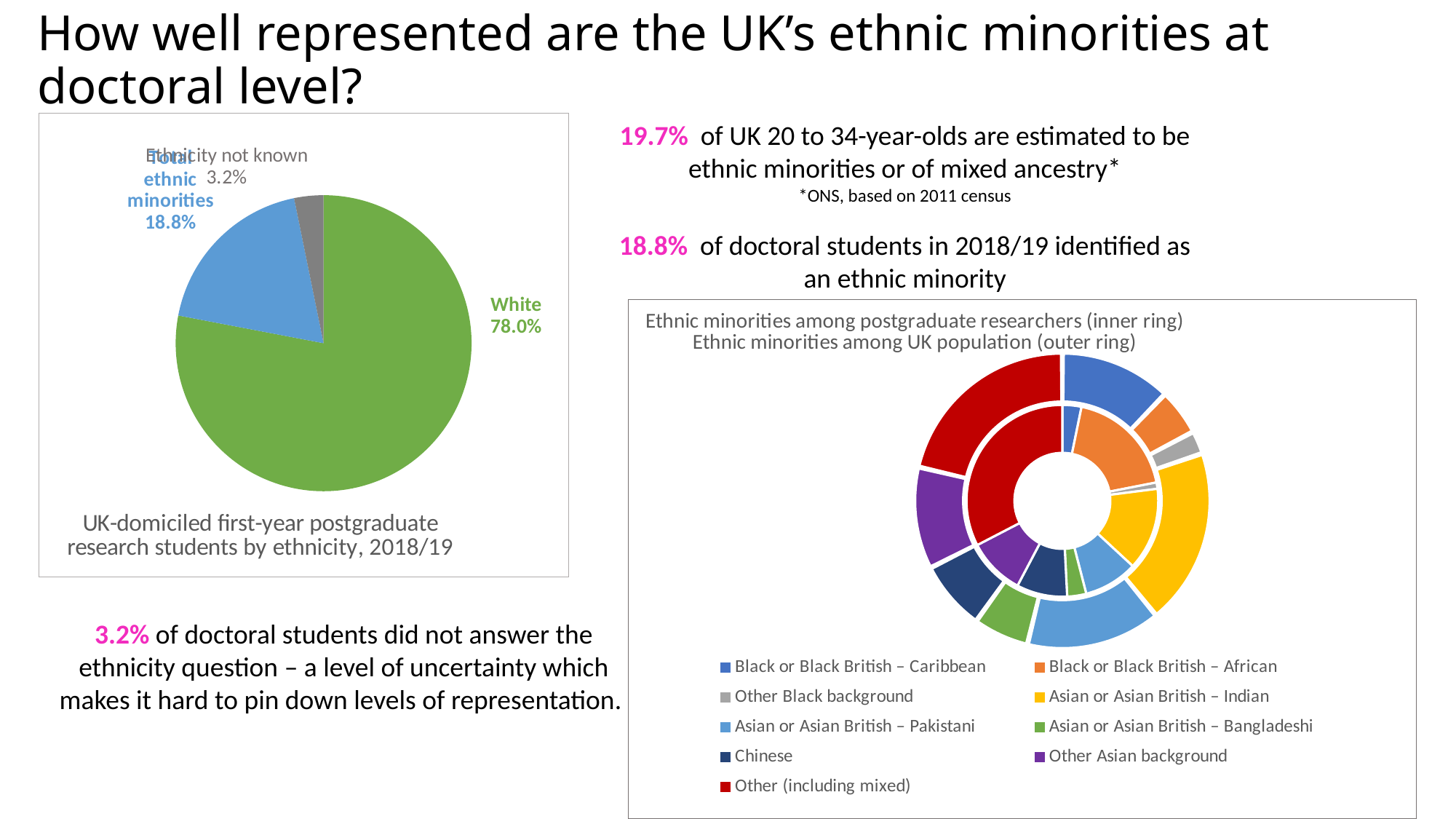
In the pie chart on the left, what percentage of UK-domiciled first-year postgraduate research students in 2018/19 were White? 78.0% What type of chart is the chart on the left of the slide? Pie chart In the pie chart on the left, what is the difference in percentage points between the White slice and the Total ethnic minorities slice? 59.2 In the pie chart on the left, what percentage is shown for Ethnicity not known? 3.2% In the pie chart on the left, what share is labelled for Total ethnic minorities? 18.8% In the doughnut chart on the right, which legend entry is shown in red? Other (including mixed) In the pie chart on the left, which category has the smallest slice? Ethnicity not known In the pie chart on the left, which category has the largest slice? White What type of chart is the chart on the right of the slide, titled 'Ethnic minorities among postgraduate researchers (inner ring)'? Doughnut chart How many ethnic groups are listed in the legend of the doughnut chart on the right? 9 In the doughnut chart on the right, which ethnic group has the smallest segment in the outer ring (UK population)? Other Black background How many slices does the pie chart on the left have? 3